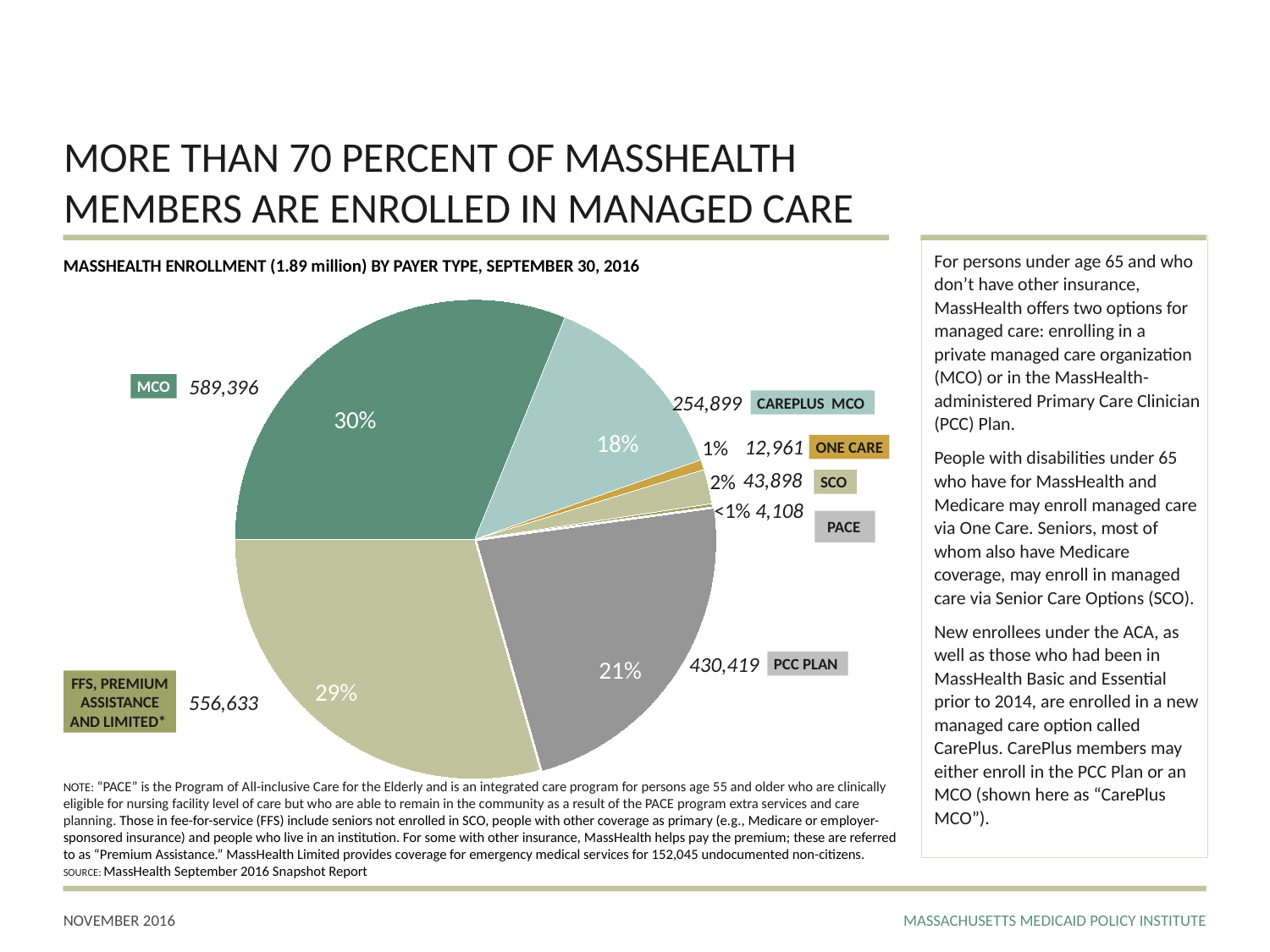
What is the difference in enrollment between MCO and PCC Plan? 158,977 What is the title of the chart? MASSHEALTH ENROLLMENT (1.89 million) BY PAYER TYPE, SEPTEMBER 30, 2016 What is the enrollment value for MCO? 589,396 Which has higher enrollment, SCO or One Care? SCO What share of the pie does CarePlus MCO represent? 18% What is the enrollment value for One Care? 12,961 What share of the pie does FFS, Premium Assistance and Limited represent? 29% What kind of chart is shown on the slide? pie chart What is the enrollment value for PCC Plan? 430,419 How many payer types are shown in the pie chart? 7 Which payer type has the smallest enrollment? PACE Which payer type has the largest enrollment? MCO